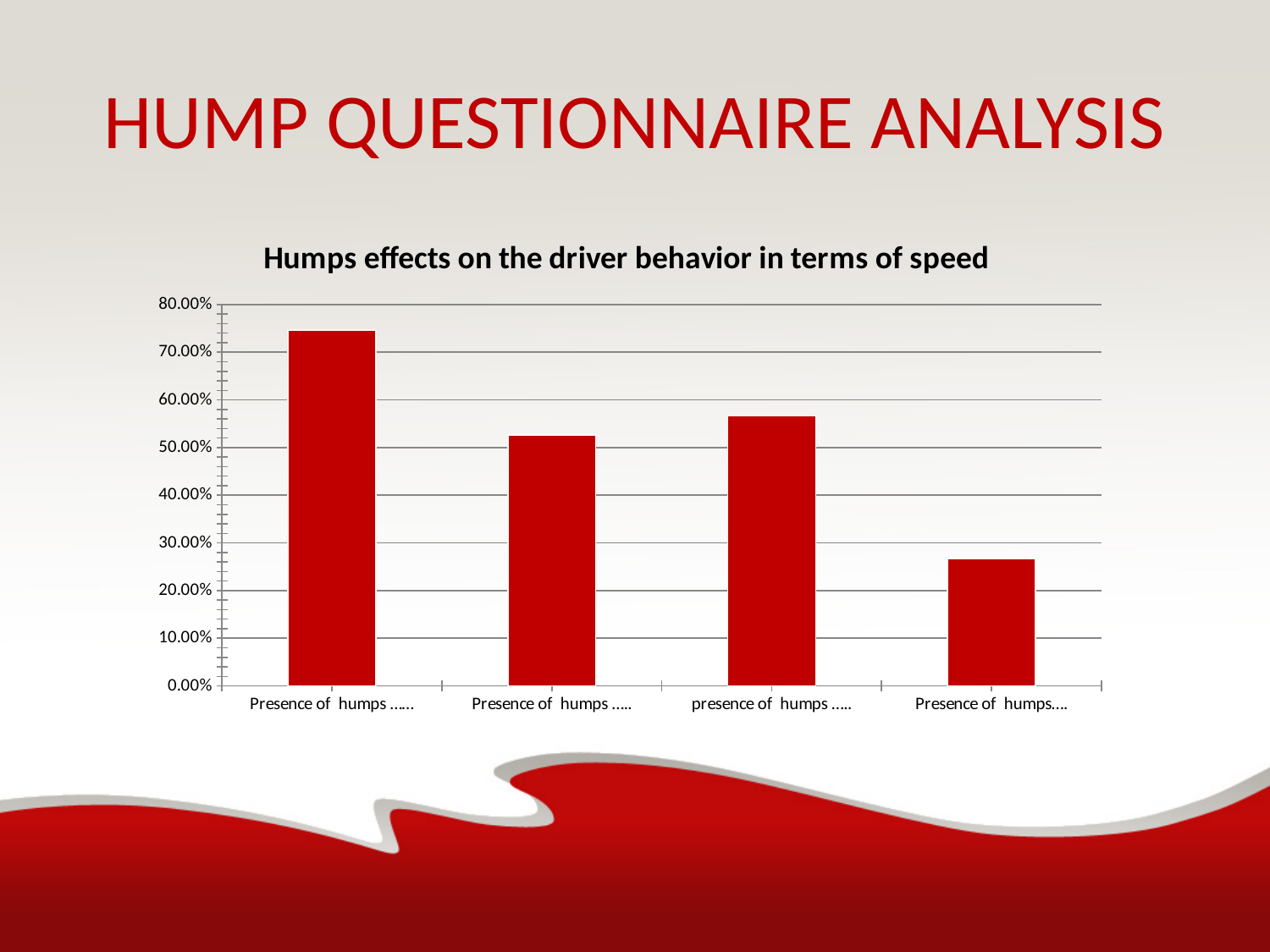
What kind of chart is shown on the slide? bar chart Is the value of the third bar greater or less than 50.00%? greater What colour are the bars in the chart? red Is the value of the fourth (rightmost) bar greater or less than 30.00%? less Is the value of the second bar greater or less than 60.00%? less What is the title of the chart? Humps effects on the driver behavior in terms of speed How many bars are plotted in the chart? 4 Which is larger, the third bar or the fourth bar? the third bar Which bar is the tallest in the chart? the first (leftmost) bar Which is larger, the first bar or the second bar? the first bar Which bar is the shortest in the chart? the fourth (rightmost) bar